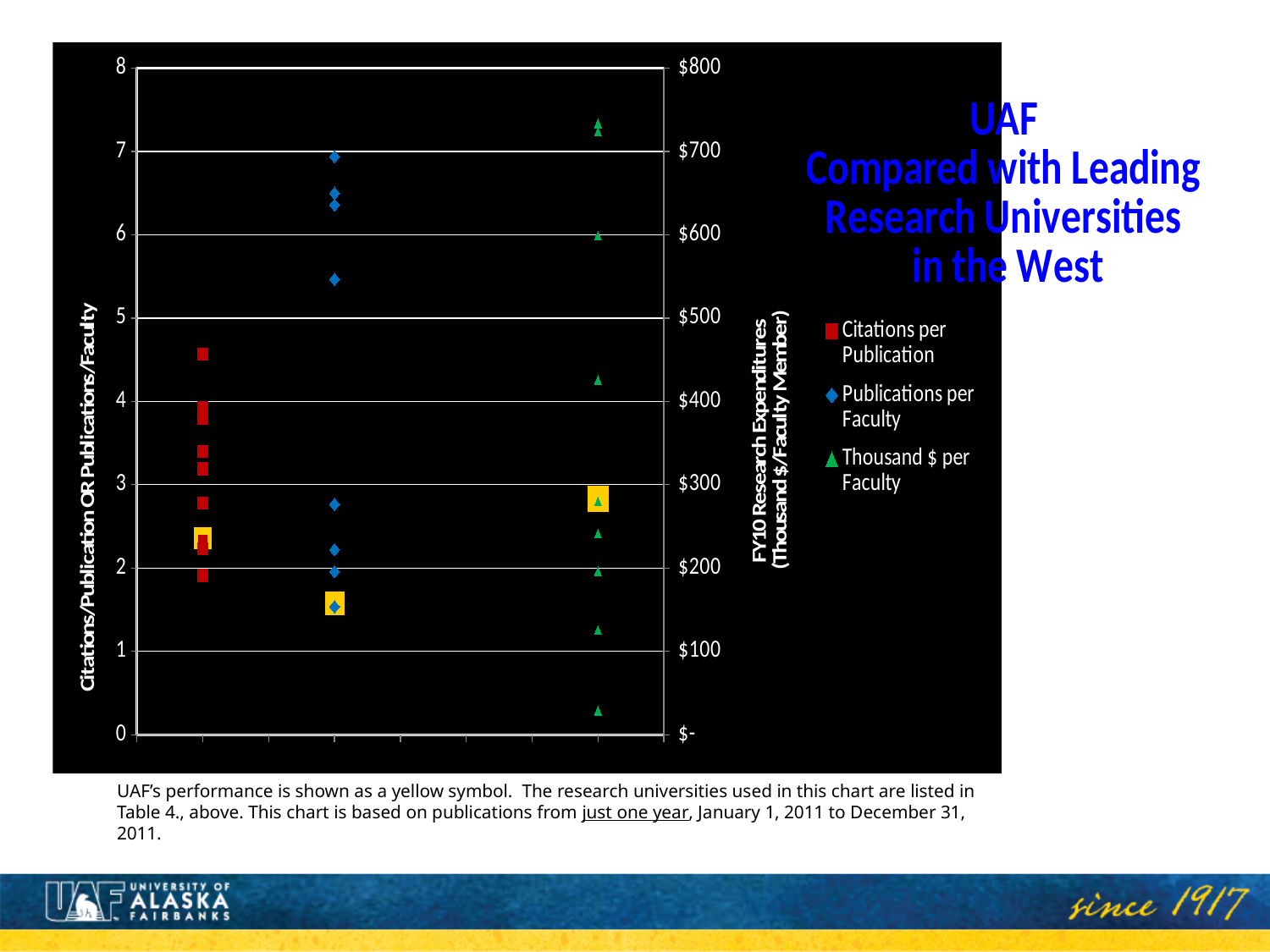
How many series does the legend list? 3 Is the lowest Thousand $ per Faculty value greater or less than $100? less Which series reaches a higher maximum on the left axis, Citations per Publication or Publications per Faculty? Publications per Faculty Which series is plotted with green triangles? Thousand $ per Faculty What kind of chart is shown on the slide? scatter chart Is the highest Citations per Publication value greater or less than 4? greater Is the highest Publications per Faculty value greater or less than 6? greater What is the title of the chart? UAF Compared with Leading Research Universities in the West